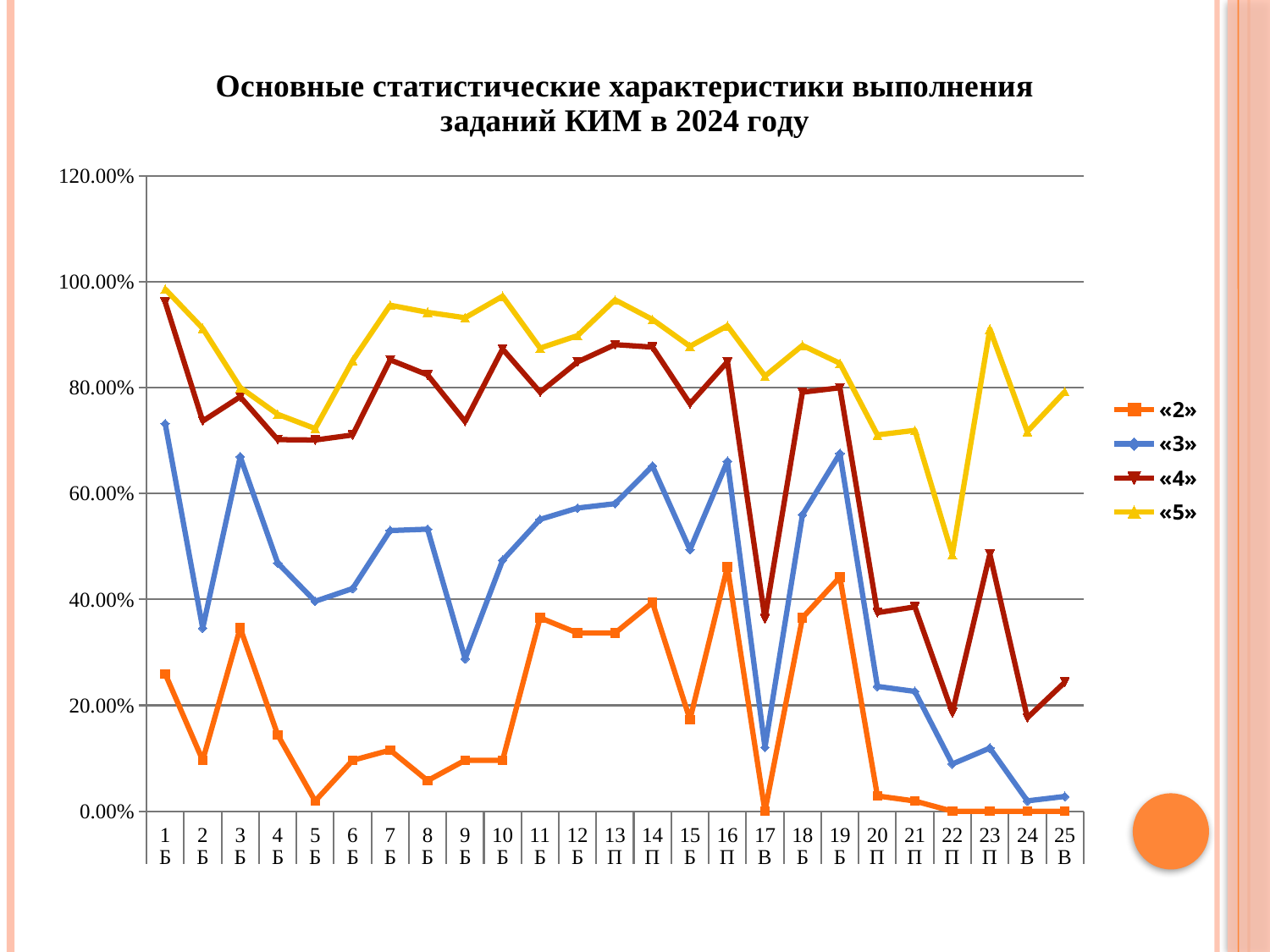
Is the value of the «5» series for task 1 Б greater or less than 80.00%? greater What is the title of the chart? Основные статистические характеристики выполнения заданий КИМ в 2024 году How many series does the legend list? 4 Is the value of the «4» series for task 23 П greater or less than 40.00%? greater Is the value of the «2» series for task 17 В greater or less than 20.00%? less Which colour is used for the «5» series? yellow Does the «2» series rise or fall from task 19 Б to task 22 П? fall What kind of chart is shown on the slide? line chart How many tasks (categories) are plotted along the x axis? 25 For task 22 П, which series has the larger value, «5» or «4»? «5» Which series has the lowest value for task 16 П? «2»